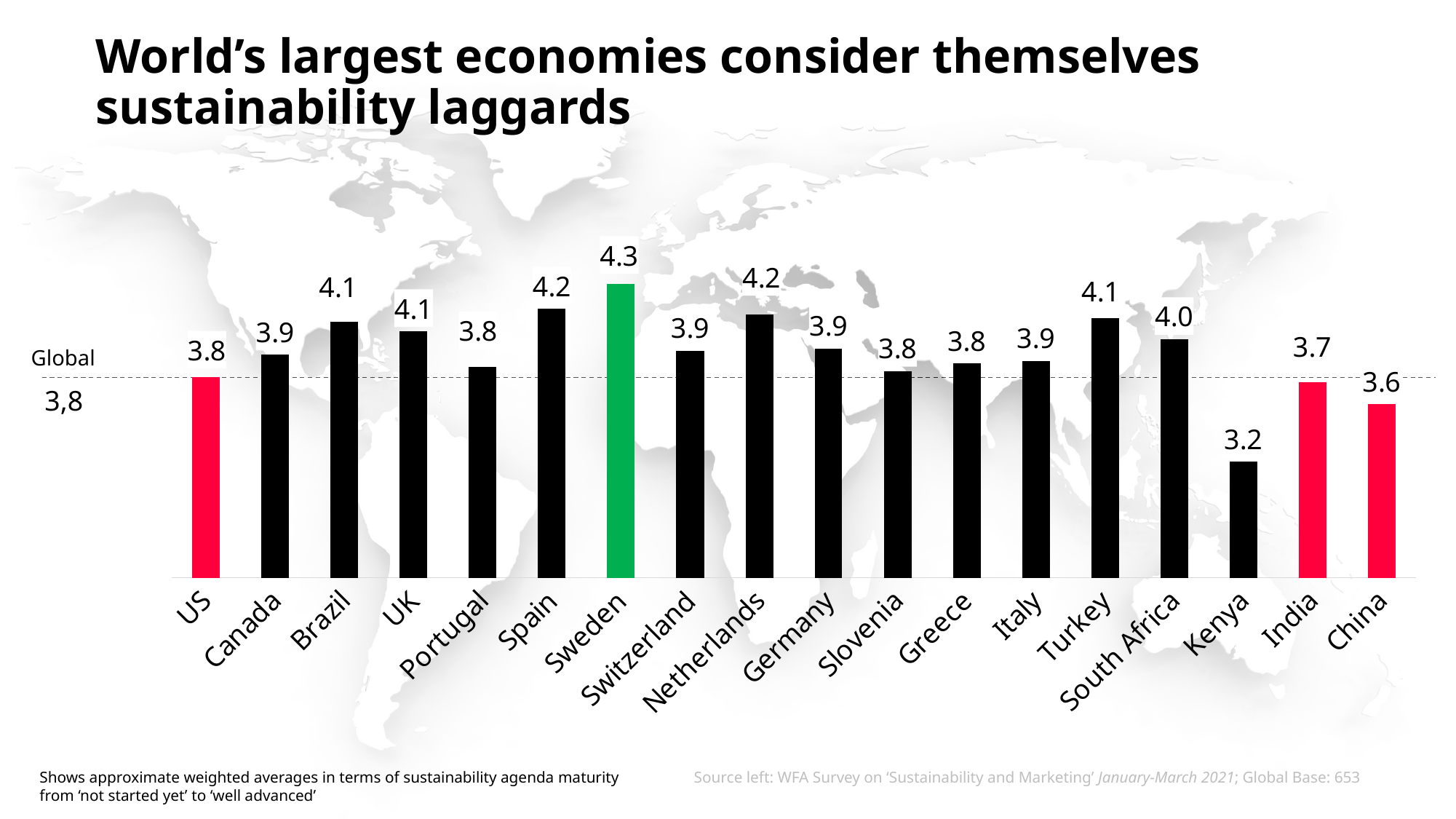
How many countries are shown in the chart? 18 Which has a higher value, Netherlands or Germany? Netherlands Which country has the lowest value? Kenya What is the value for Kenya? 3.2 What is the difference between the values for Spain and India? 0.5 What kind of chart is shown on the slide? Bar chart What is the Global value marked by the dashed line? 3,8 What is the value for South Africa? 4.0 Which country has the highest value? Sweden What is the difference between the values for Sweden and Kenya? 1.1 What is the value for Sweden? 4.3 What is the value for China? 3.6